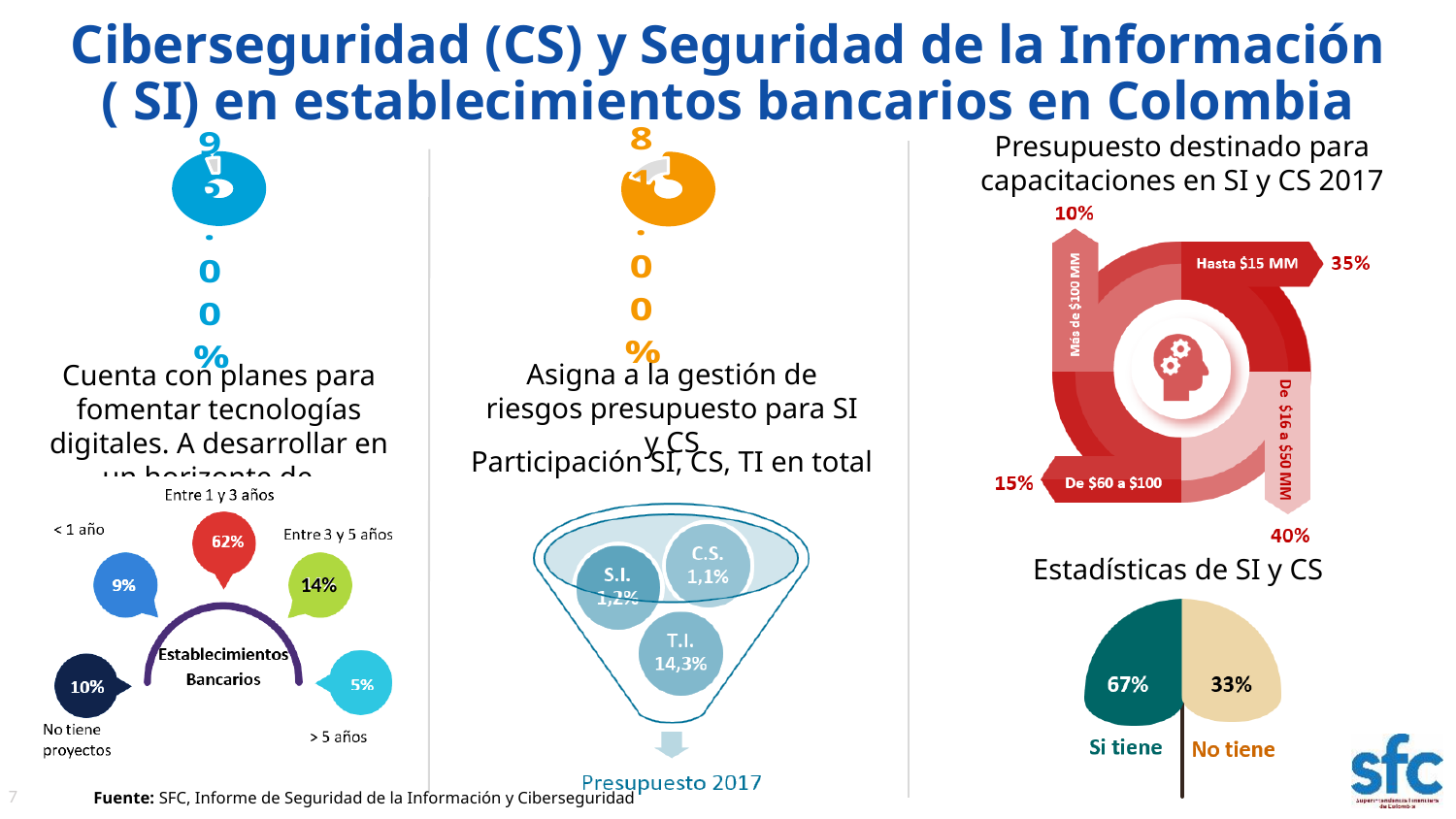
In the chart 'Presupuesto destinado para capacitaciones en SI y CS 2017', which range has the lowest percentage? Más de $100 MM In the chart 'Presupuesto destinado para capacitaciones en SI y CS 2017', what percentage corresponds to 'De $16 a $50 MM'? 40% In the 'Establecimientos Bancarios' chart at the bottom left, which category has the lowest percentage? > 5 años In the funnel chart 'Participación SI, CS, TI en total Presupuesto 2017', which is larger, S.I. or C.S.? S.I. In the funnel chart 'Participación SI, CS, TI en total Presupuesto 2017', what is the value for T.I.? 14,3% In the funnel chart 'Participación SI, CS, TI en total Presupuesto 2017', what is the value for C.S.? 1,1% In the 'Establecimientos Bancarios' chart at the bottom left, how many categories are shown? 5 In the chart 'Presupuesto destinado para capacitaciones en SI y CS 2017', what is the difference between 'Hasta $15 MM' and 'De $60 a $100'? 20% In the 'Estadísticas de SI y CS' chart at the bottom right, what percentage corresponds to 'Si tiene'? 67% In the 'Establecimientos Bancarios' chart at the bottom left, what percentage corresponds to 'No tiene proyectos'? 10% In the 'Establecimientos Bancarios' chart at the bottom left, what percentage corresponds to 'Entre 1 y 3 años'? 62% In the 'Establecimientos Bancarios' chart at the bottom left, which category has the highest percentage? Entre 1 y 3 años